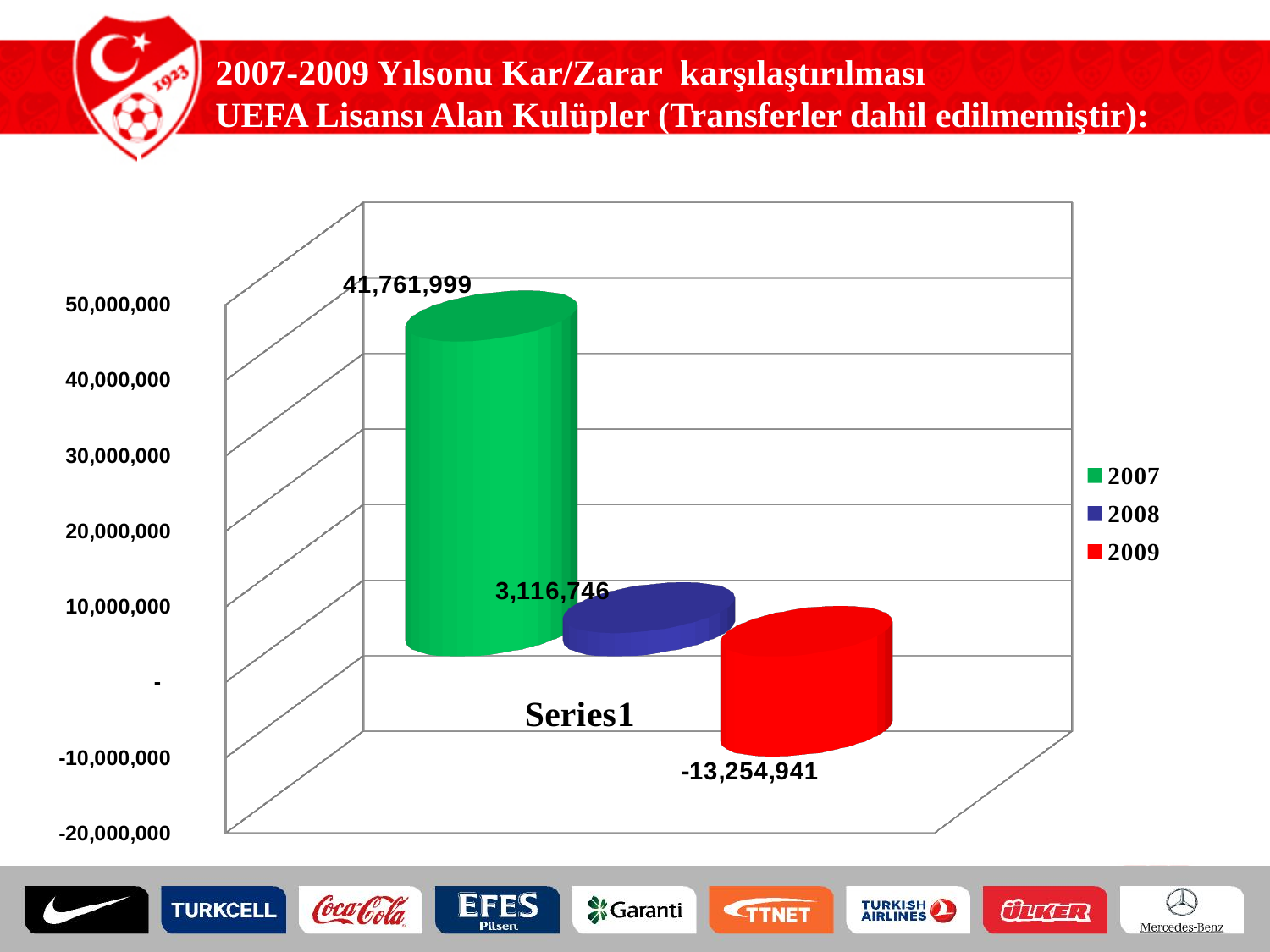
What kind of chart is shown on the slide? bar chart What is the value for 2007? 41,761,999 What is the value for 2008? 3,116,746 What is the difference between the values for 2008 and 2009? 16,371,687 Which year has the highest value? 2007 Which year has the lowest value? 2009 What is the difference between the values for 2007 and 2008? 38,645,253 How many series does the legend list? 3 What is the value for 2009? -13,254,941 Which is larger, the value for 2008 or the value for 2009? 2008 Is the value for 2007 greater or less than 40,000,000? greater What colour is the bar for 2009? red